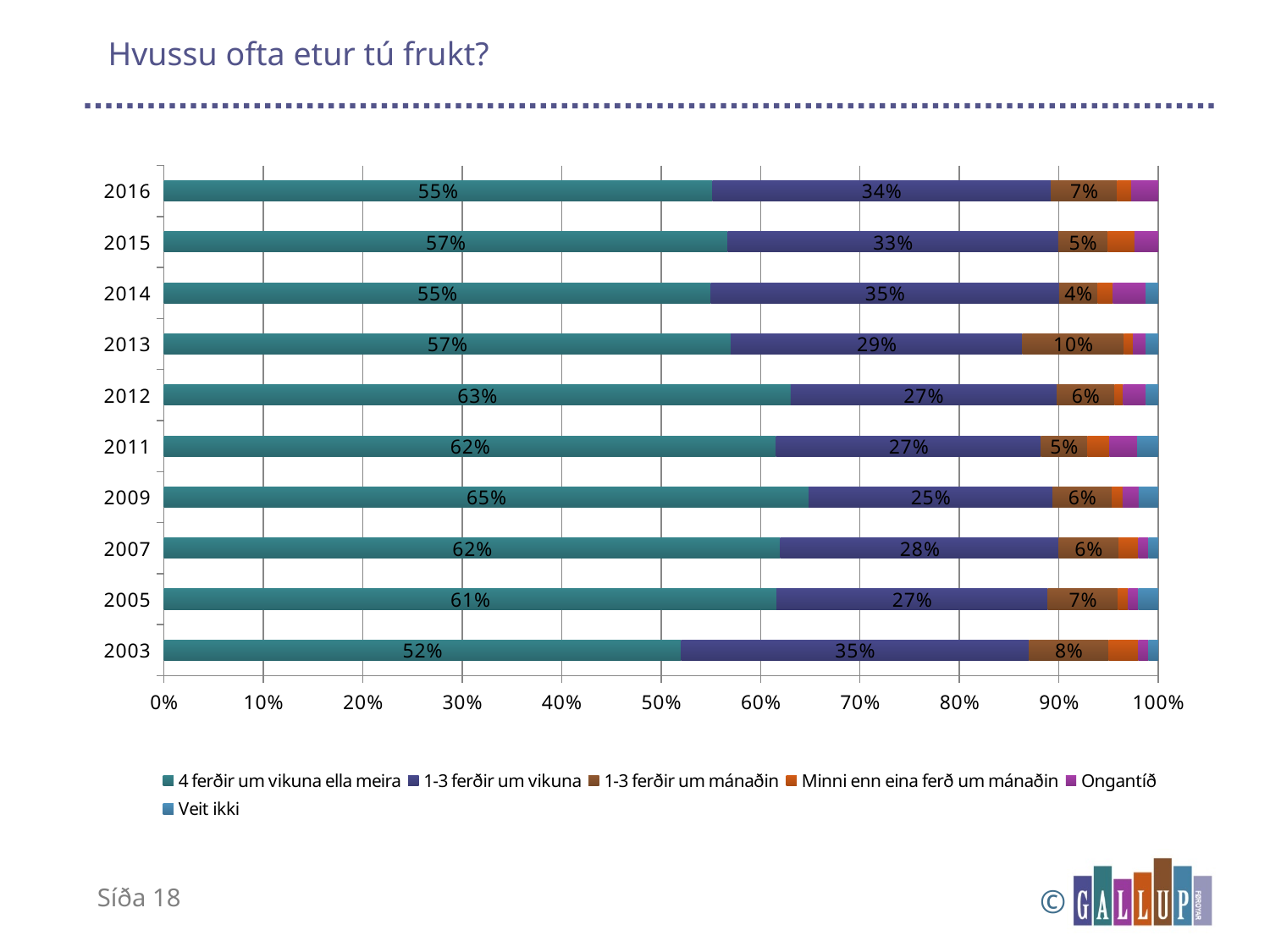
What kind of chart is shown on the slide? bar chart What is the title of the chart? Hvussu ofta etur tú frukt? What is the difference between the '4 ferðir um vikuna ella meira' values for 2009 and 2003? 13 percentage points Which year has the highest value for '4 ferðir um vikuna ella meira'? 2009 Which year has the highest value for '1-3 ferðir um mánaðin'? 2013 Which year has the larger value for '4 ferðir um vikuna ella meira', 2012 or 2016? 2012 What is the value for '1-3 ferðir um vikuna' in 2003? 35% What is the value for '1-3 ferðir um mánaðin' in 2013? 10% What is the value for '4 ferðir um vikuna ella meira' in 2016? 55% How many years are shown on the chart? 10 How many series does the legend list? 6 Which year has the lowest value for '4 ferðir um vikuna ella meira'? 2003